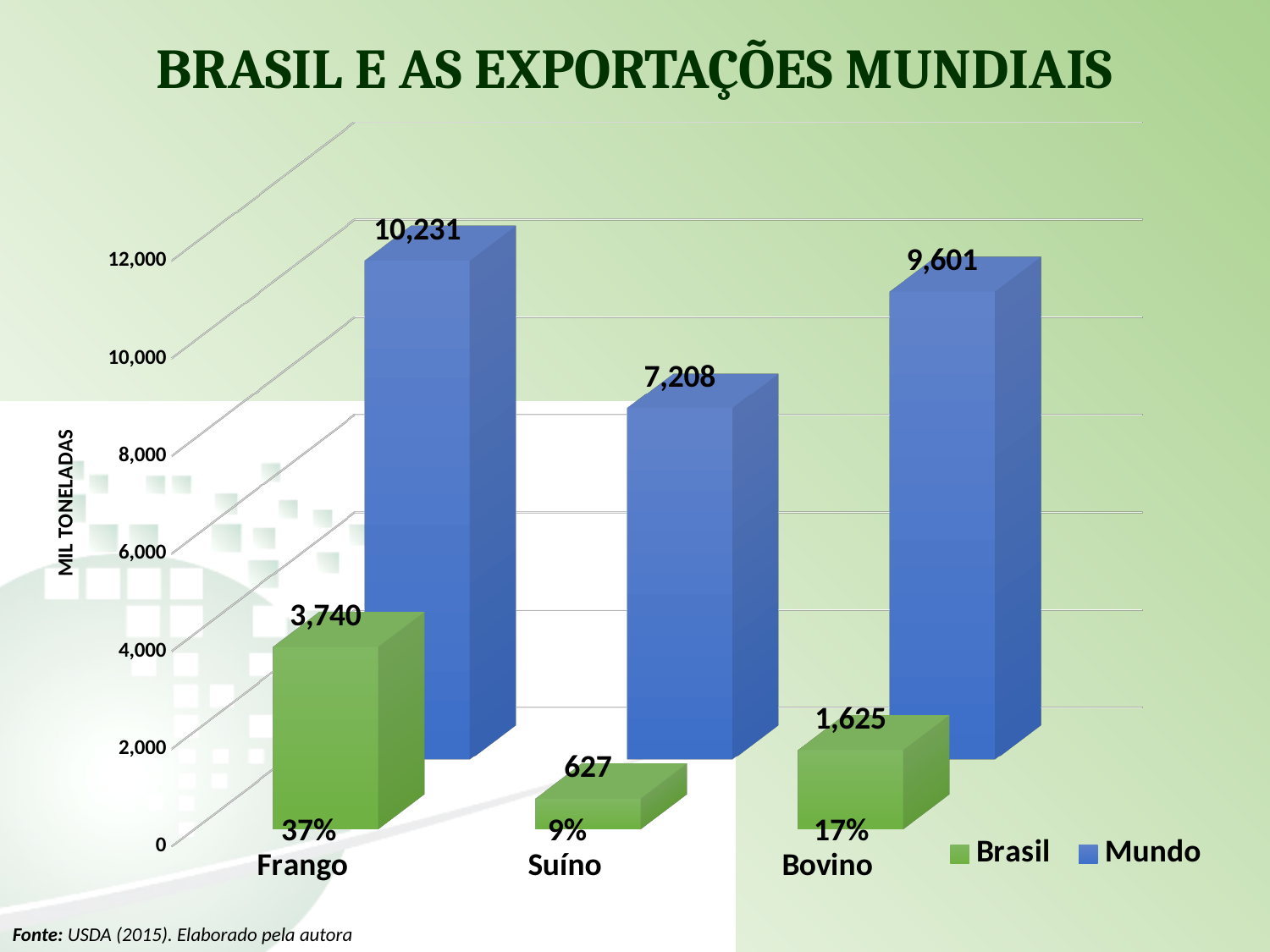
Which category has the highest Mundo value? Frango What is the value for Brasil in the Bovino category? 1,625 What kind of chart is shown on the slide? Bar chart What is the value for Mundo in the Bovino category? 9,601 What percentage label is shown under the Suíno category? 9% What is the value for Brasil in the Frango category? 3,740 How many series does the legend list? 2 Which is larger, the Mundo value for Suíno or the Mundo value for Bovino? Bovino Which category has the lowest Brasil value? Suíno How many categories are shown on the x axis? 3 What is the difference between the Mundo and Brasil values for Frango? 6,491 What is the value for Mundo in the Suíno category? 7,208